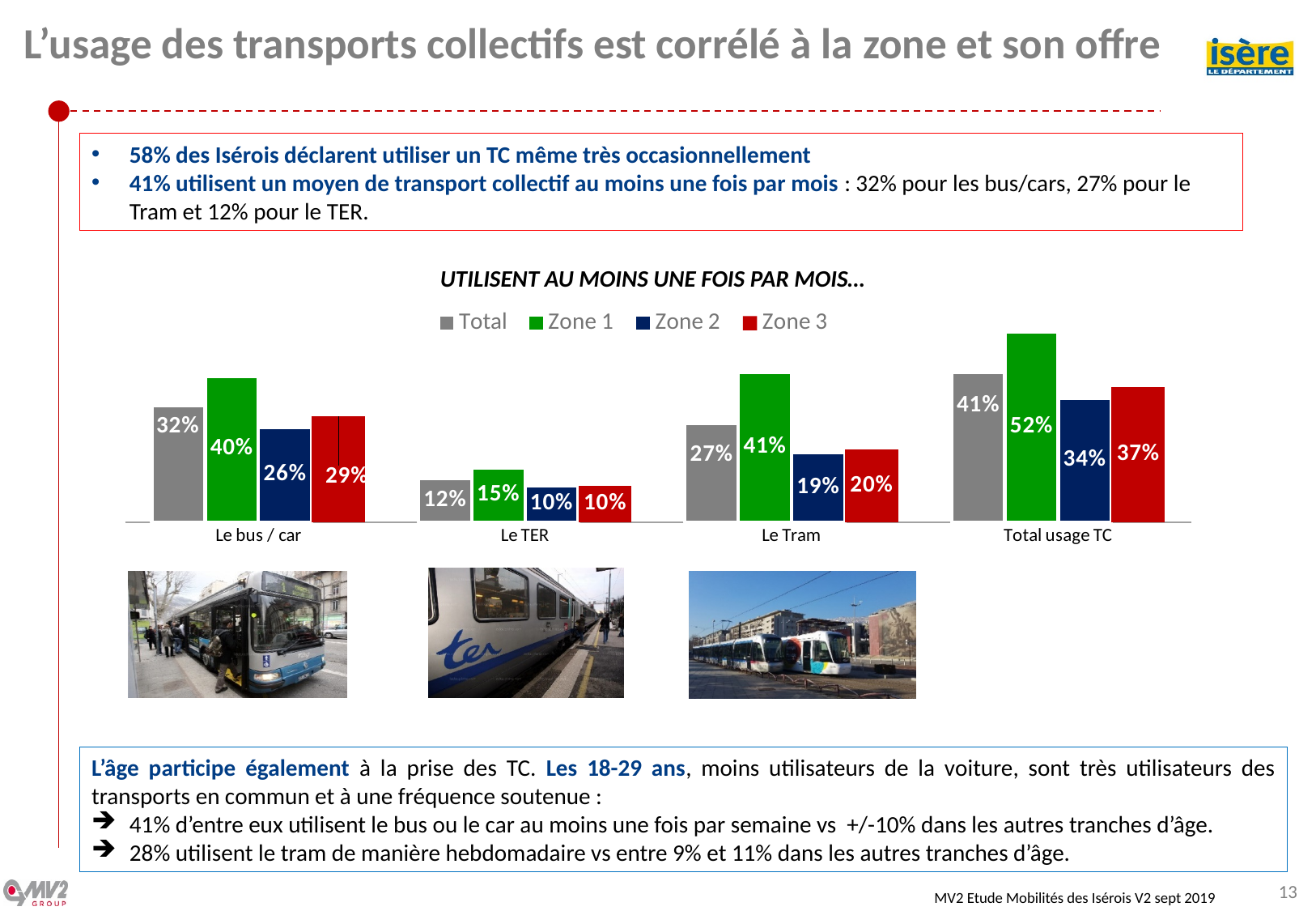
How many series does the legend list? 4 What is the Zone 3 value for Le TER? 10% What is the Zone 2 value for Le Tram? 19% Which category has the lowest Total value? Le TER What kind of chart is shown? Bar chart What is the Total value for Total usage TC? 41% What is the difference between the Zone 1 and Zone 2 values for Le Tram? 22% What is the title of the chart? UTILISENT AU MOINS UNE FOIS PAR MOIS… Which is larger for Le bus / car: the Zone 2 value or the Zone 3 value? Zone 3 How many categories are shown on the x axis? 4 Which category has the highest Zone 1 value? Total usage TC What is the Zone 1 value for Le bus / car? 40%